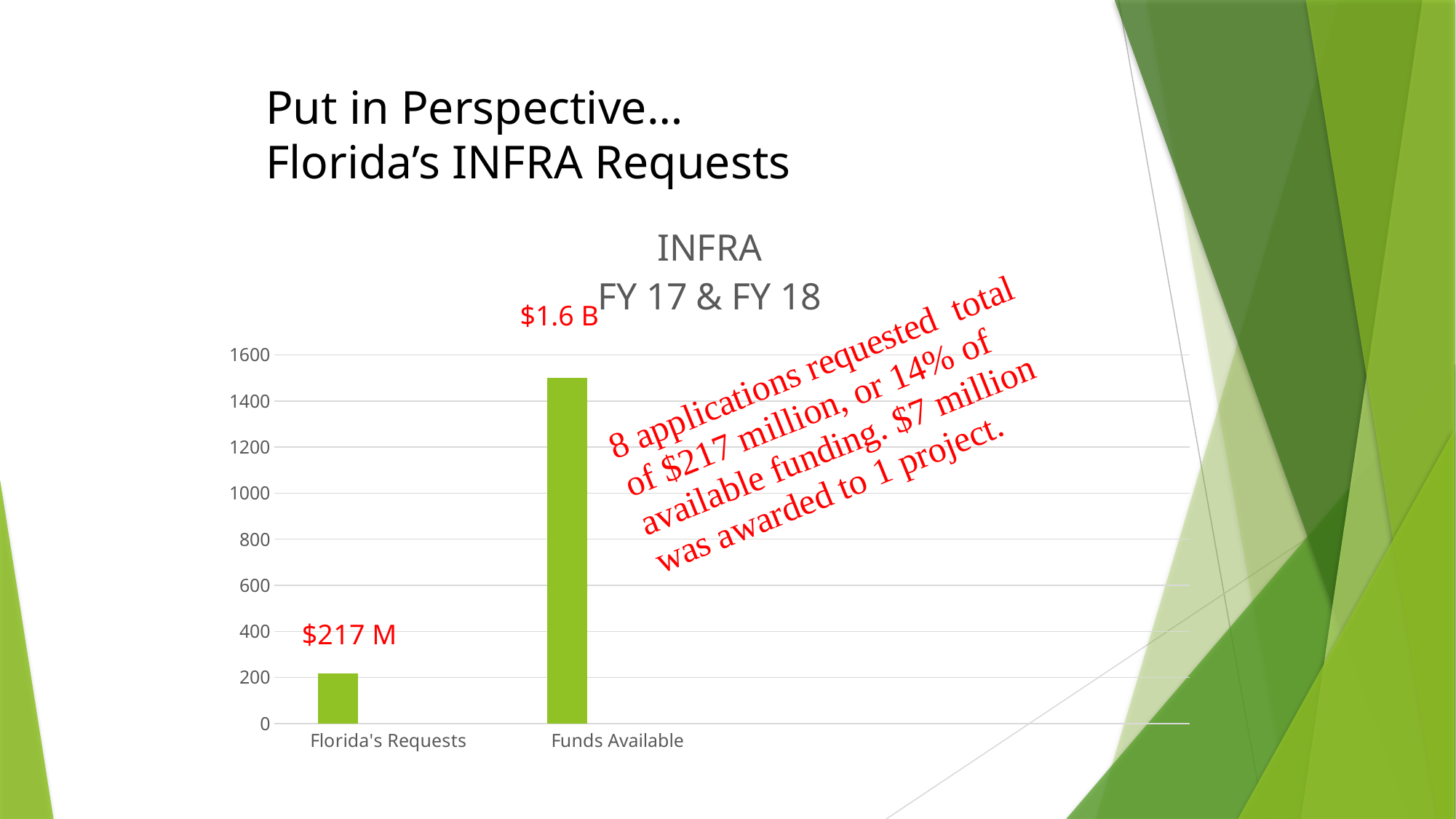
Which category has the highest bar in the chart? Funds Available Do the bar values rise or fall from Florida's Requests to Funds Available? rise What value is labelled on the slide for Florida's Requests? $217 M Is the value for Florida's Requests greater or less than 400 on the axis? less What kind of chart is shown on the slide? bar chart What colour are the bars in the chart? green What is the title of the chart? INFRA FY 17 & FY 18 Which is larger, the bar for Florida's Requests or the bar for Funds Available? Funds Available How many categories are plotted on the x axis of the chart? 2 Is the value for Funds Available greater or less than 1400 on the axis? greater What value is labelled on the slide for Funds Available? $1.6 B Which category has the lowest bar in the chart? Florida's Requests